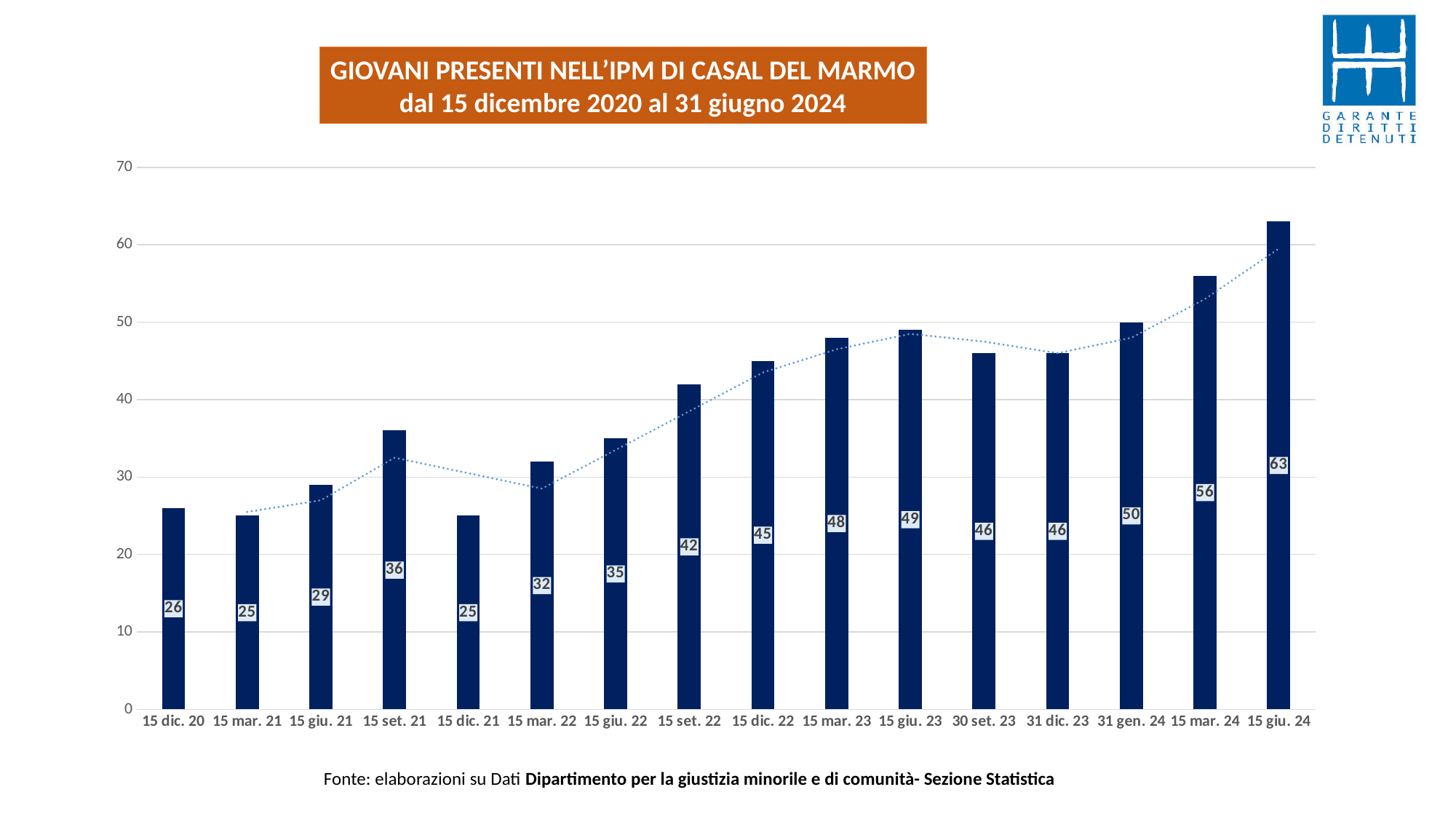
Do the values generally rise or fall from 15 dic. 20 to 15 giu. 24? rise What is the value for 15 set. 21? 36 What is the difference between the values for 15 set. 22 and 15 giu. 22? 7 What is the difference between the values for 15 giu. 24 and 15 mar. 24? 7 What kind of chart is shown on the slide? bar chart What is the lowest value shown on the chart? 25 Which is larger, the value for 15 set. 21 or the value for 15 mar. 22? 15 set. 21 Which date has the highest value? 15 giu. 24 What is the value for 15 giu. 24? 63 What is the value for 31 gen. 24? 50 Is the value for 15 mar. 24 greater or less than 50? greater How many dates are shown on the x axis? 16